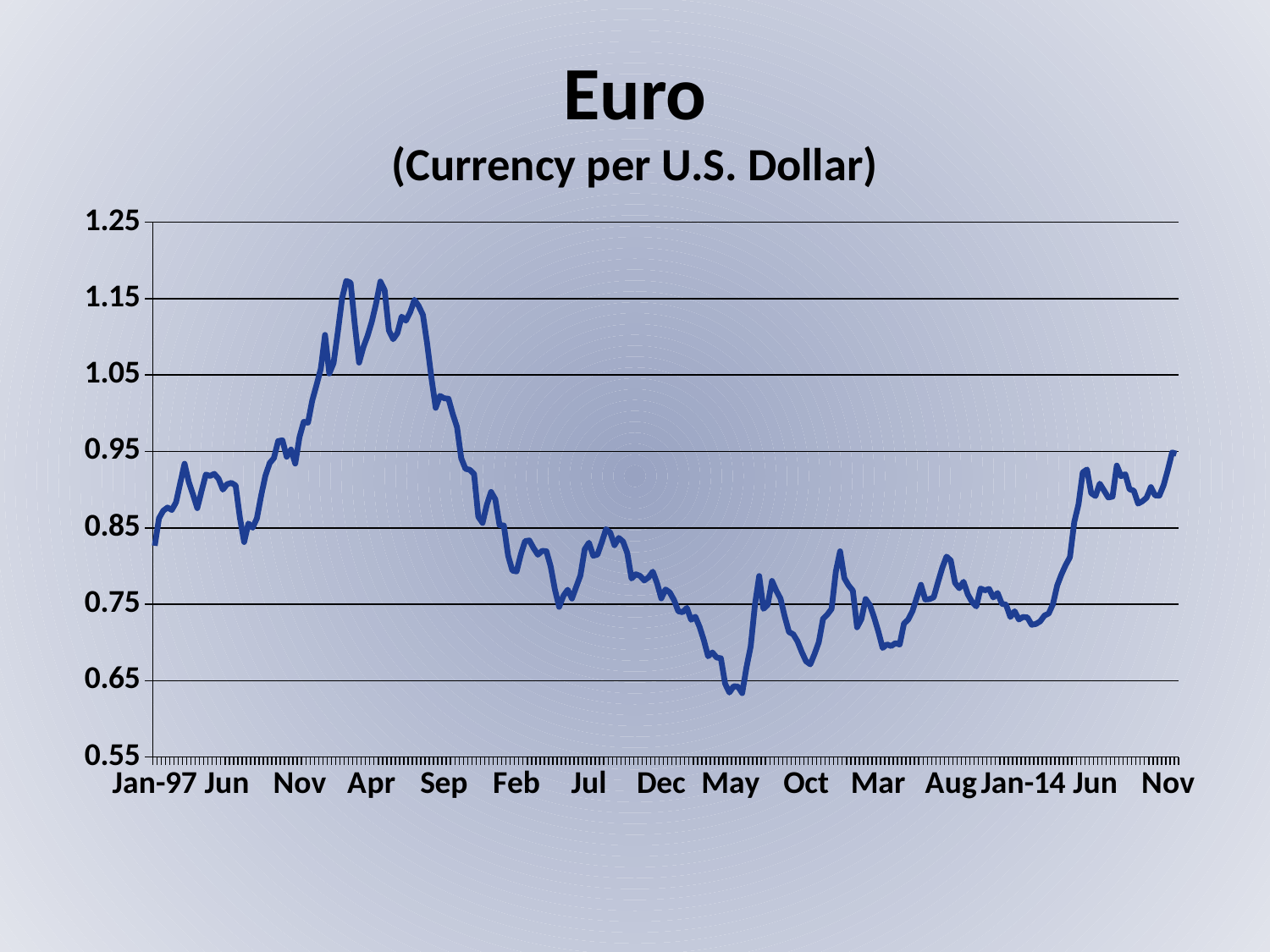
Is the value at Jan-97 greater or less than 0.85? less Is the value at Apr greater or less than 1.05? greater Around which x-axis label does the line reach its highest value? Apr Is the value at Oct greater or less than 0.75? less Does the line rise or fall between Jan-14 and Nov? rise Does the line rise or fall between Jan-97 and Apr? rise What kind of chart is shown on the slide? line chart Around which x-axis label does the line reach its lowest value? May What is the title of the chart? Euro What unit does the chart subtitle say the values are in? Currency per U.S. Dollar